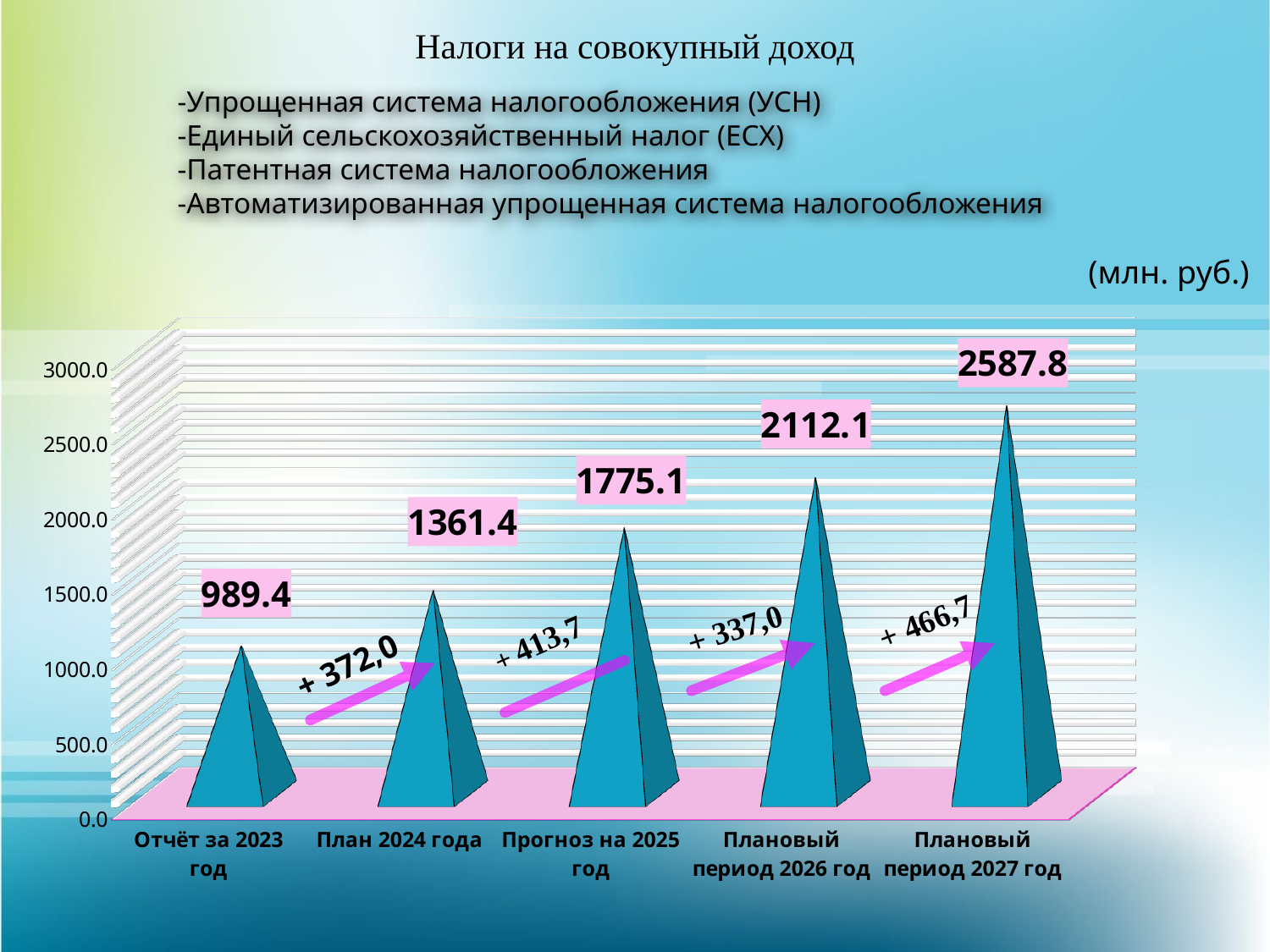
Which is larger, the value for 'Плановый период 2026 год' or 'Прогноз на 2025 год'? Плановый период 2026 год How many categories are shown on the chart? 5 What is the value for 'План 2024 года'? 1361.4 Do the values rise or fall from 2023 to 2027 along the x axis? rise Which category has the highest value? Плановый период 2027 год What kind of chart is shown on the slide? bar chart What is the value for 'Отчёт за 2023 год'? 989.4 What is the difference between the values for 'План 2024 года' and 'Отчёт за 2023 год'? 372.0 What is the difference between the values for 'Плановый период 2027 год' and 'Отчёт за 2023 год'? 1598.4 Which category has the lowest value? Отчёт за 2023 год What is the value for 'Плановый период 2027 год'? 2587.8 What is the value for 'Прогноз на 2025 год'? 1775.1